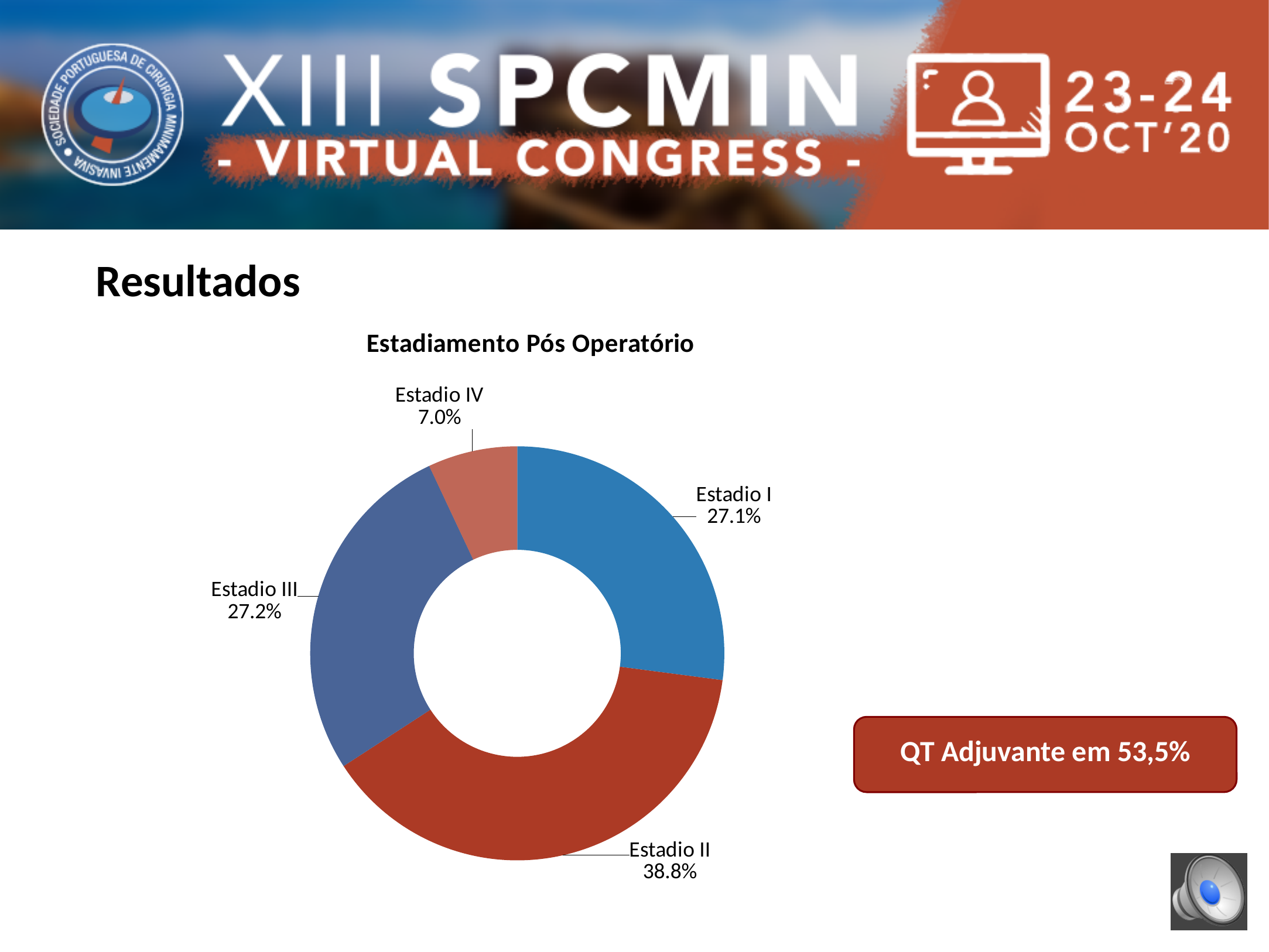
Which stage has the smallest share of the chart? Estadio IV What colour is the Estadio II slice? Red What is the difference in percentage points between Estadio II and Estadio IV? 31.8 What is the value shown for Estadio I? 27.1% What is the value shown for Estadio IV? 7.0% What share of the chart does Estadio II represent? 38.8% Which is larger, the share for Estadio II or the share for Estadio I? Estadio II What kind of chart is shown on the slide? Doughnut (pie) chart What is the value shown for Estadio III? 27.2% How many stages (categories) are shown in the chart? 4 What is the title of the chart? Estadiamento Pós Operatório Which stage has the largest share of the chart? Estadio II